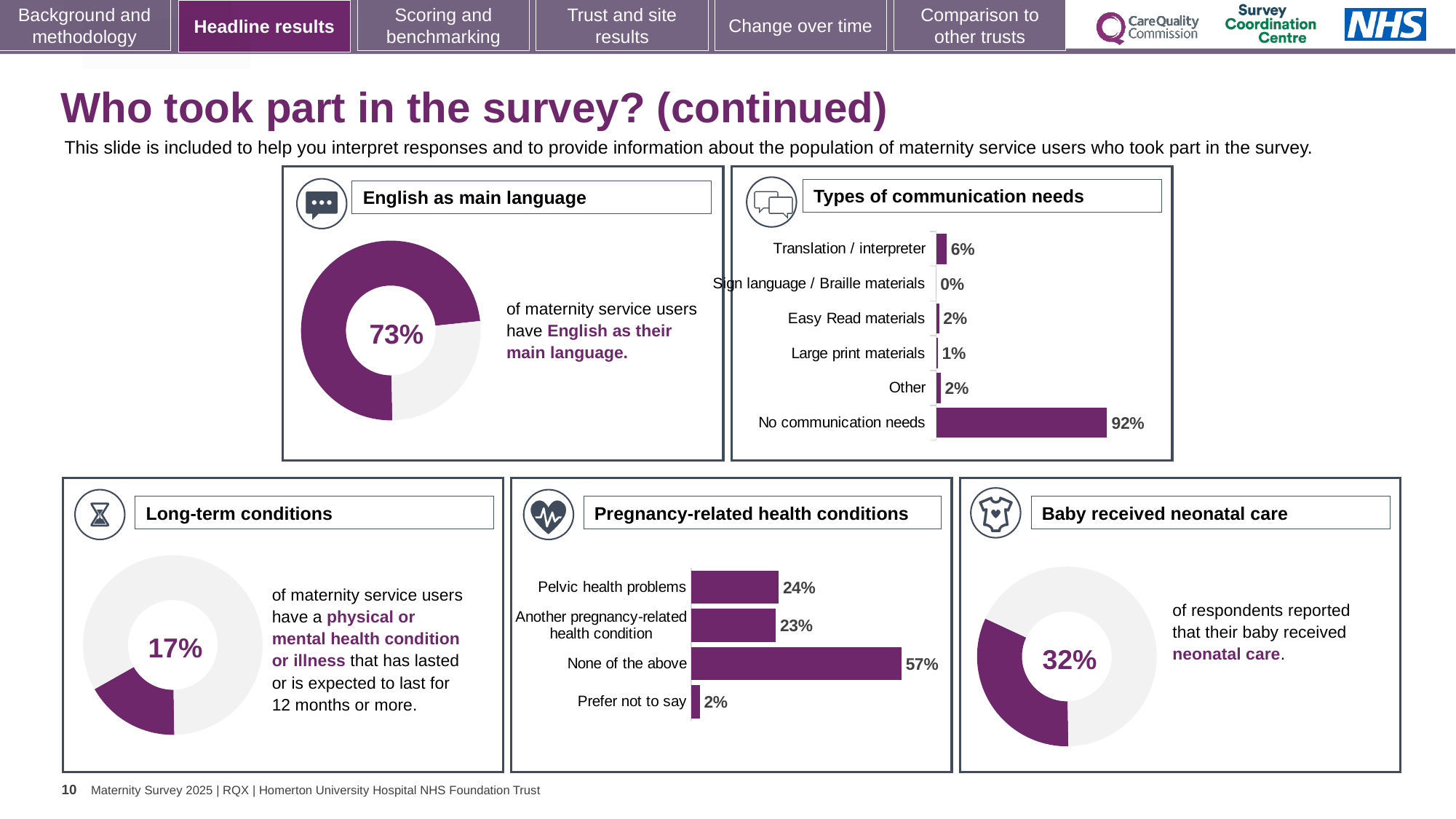
In the 'Pregnancy-related health conditions' chart, what is the value for Pelvic health problems? 24% In the 'Types of communication needs' chart, how many categories are shown? 6 In the 'Types of communication needs' chart, what is the value for Translation / interpreter? 6% In the 'Baby received neonatal care' chart, what percentage of respondents reported that their baby received neonatal care? 32% In the 'English as main language' chart, what percentage of maternity service users have English as their main language? 73% In the 'Long-term conditions' chart, what percentage of maternity service users have a physical or mental health condition or illness? 17% In the 'Pregnancy-related health conditions' chart, which category has the lowest value? Prefer not to say What kind of chart is the 'Pregnancy-related health conditions' chart? Bar chart In the 'Pregnancy-related health conditions' chart, what is the difference between None of the above and Another pregnancy-related health condition? 34% Which is larger: the 'Long-term conditions' value or the 'Baby received neonatal care' value? Baby received neonatal care In the 'Types of communication needs' chart, which category has the highest value? No communication needs In the 'Types of communication needs' chart, what is the difference between No communication needs and Translation / interpreter? 86%